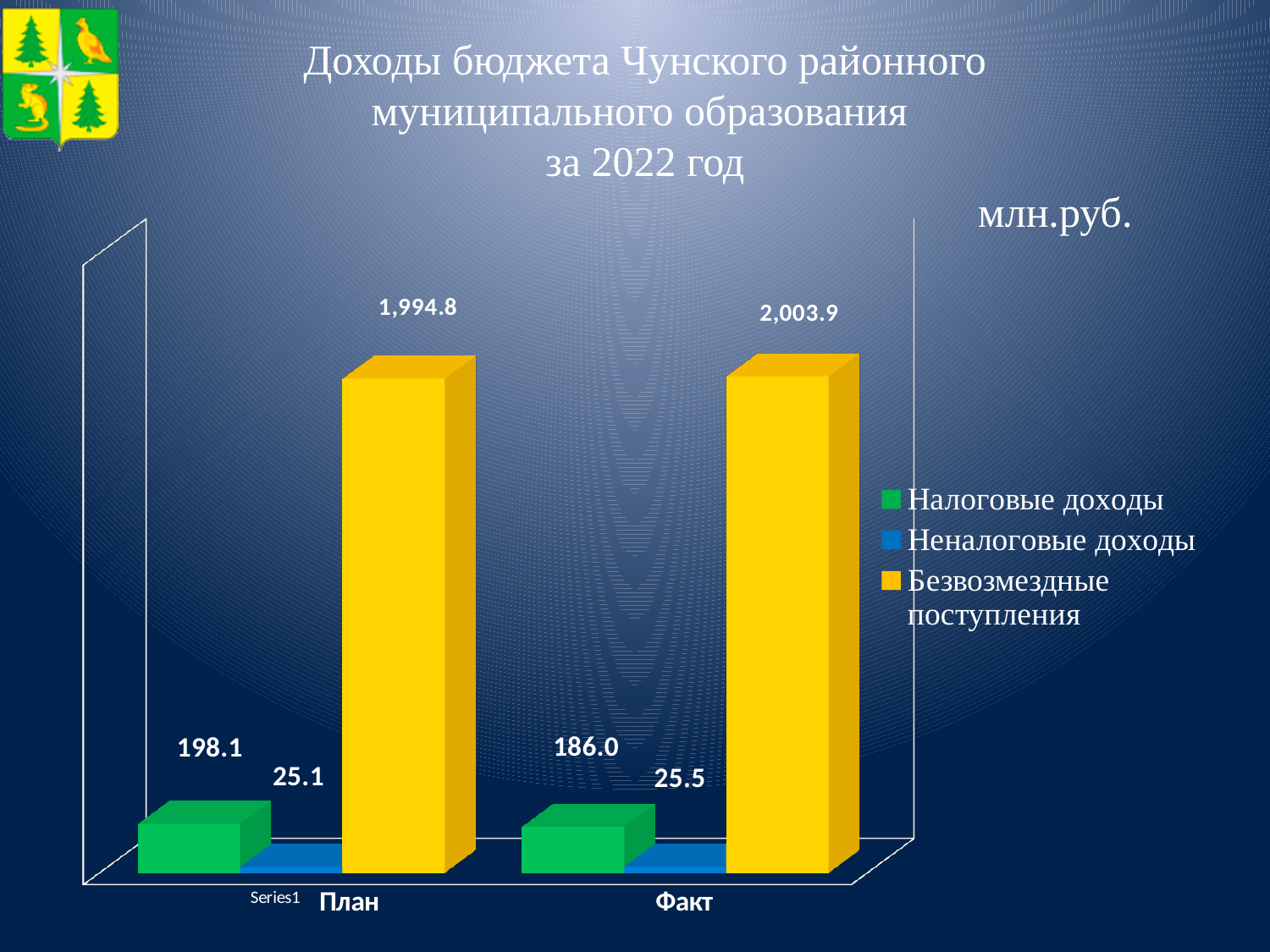
What is the value of Безвозмездные поступления for План? 1,994.8 What is the value of Безвозмездные поступления for Факт? 2,003.9 What is the value of Неналоговые доходы for Факт? 25.5 How many categories are shown on the x axis? 2 How many series does the legend list? 3 Which series has the lowest value for План? Неналоговые доходы Which is larger: Безвозмездные поступления for План or for Факт? Факт What colour represents Неналоговые доходы in the chart? Blue What kind of chart is shown on the slide? Bar chart Which series has the highest value for Факт? Безвозмездные поступления What is the value of Налоговые доходы for План? 198.1 What is the difference between Налоговые доходы for План and for Факт? 12.1